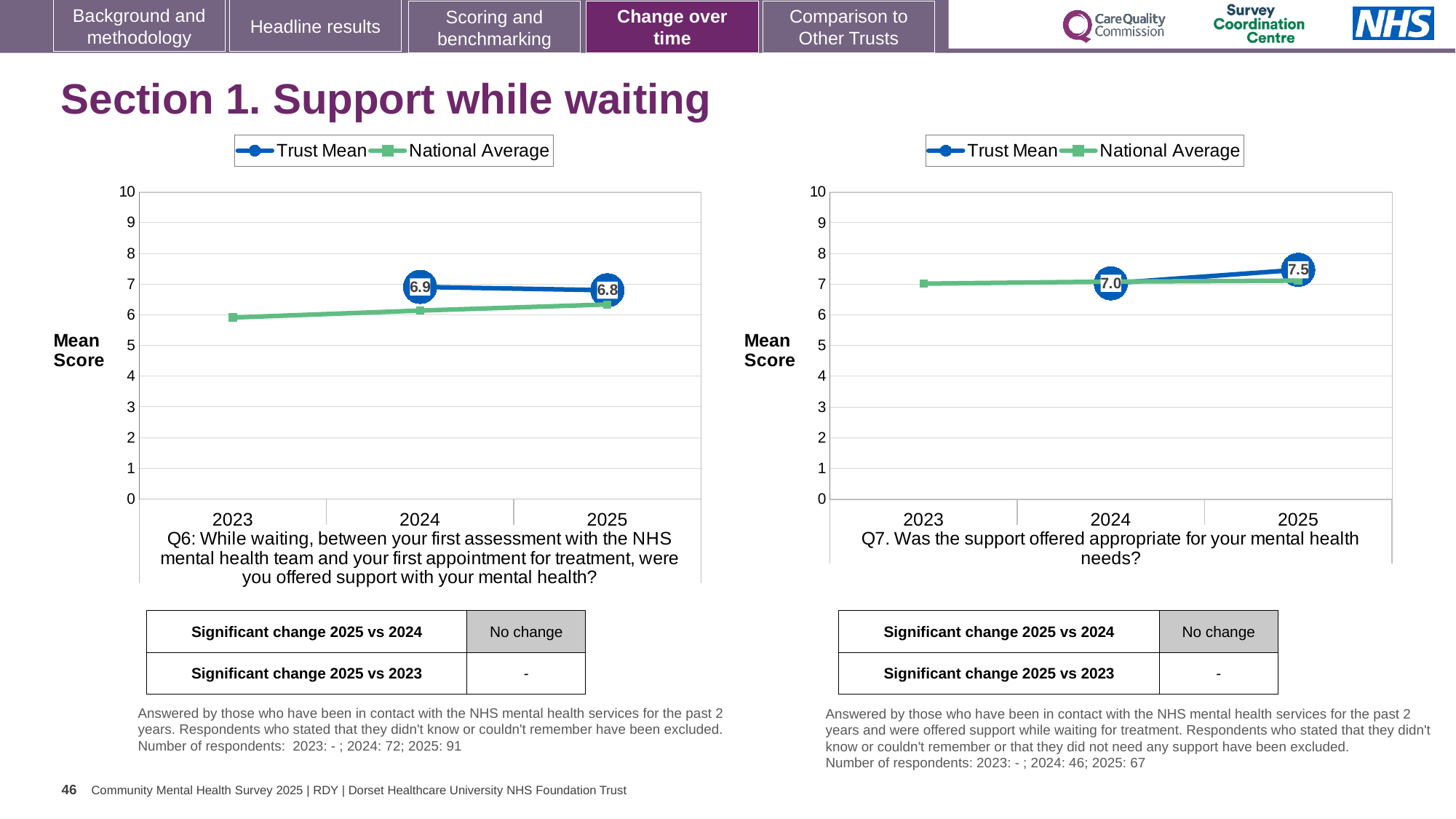
In the Q7 chart on the right, by how much did the Trust Mean change from 2024 to 2025? 0.5 In the Q7 chart on the right, what is the Trust Mean for 2025? 7.5 In the Q6 chart on the left, is the Trust Mean for 2024 higher or lower than the National Average for 2024? higher In the Q7 chart on the right, what is the Trust Mean for 2024? 7.0 In the Q6 chart on the left, what is the Trust Mean for 2025? 6.8 How many series does the legend of the Q7 chart on the right list? 2 In the Q6 chart on the left, what is the Trust Mean for 2024? 6.9 How many years are shown on the x axis of the Q7 chart on the right? 3 In the Q6 chart on the left, by how much did the Trust Mean change from 2024 to 2025? 0.1 What kind of chart is the Q6 chart on the left? line chart In the Q7 chart on the right, does the Trust Mean rise or fall from 2024 to 2025? rise